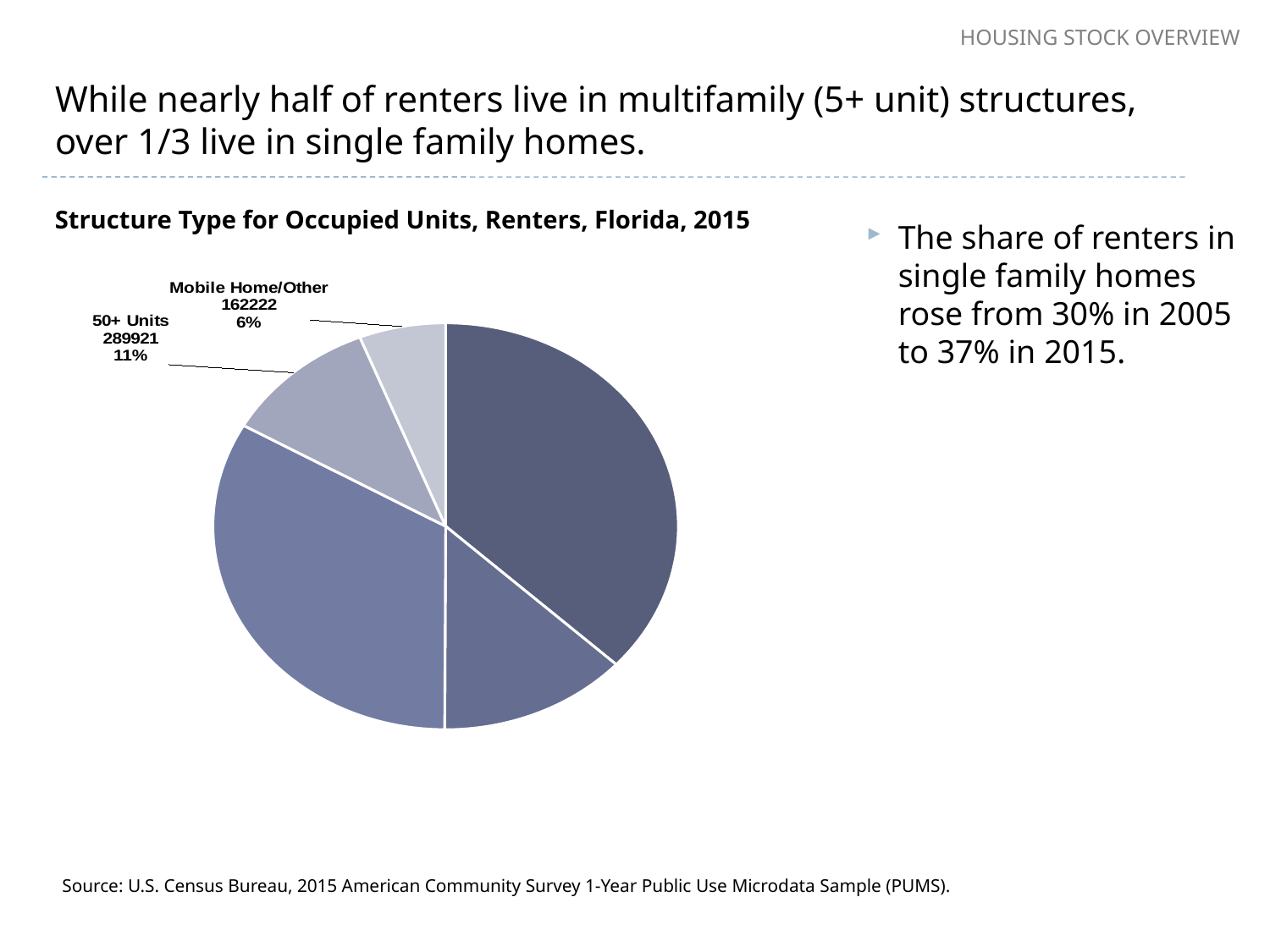
What share of the pie does 50+ Units represent? 11% What is the title of the chart? Structure Type for Occupied Units, Renters, Florida, 2015 What is the value shown for Mobile Home/Other? 162222 What kind of chart is shown on the slide? Pie chart How many slices does the pie chart have? 5 Which labeled category has the smallest slice of the pie? Mobile Home/Other What share of the pie does Mobile Home/Other represent? 6% By how many percentage points does the share for 50+ Units exceed the share for Mobile Home/Other? 5% What is the difference between the values for 50+ Units and Mobile Home/Other? 127699 Which is larger, the slice for 50+ Units or the slice for Mobile Home/Other? 50+ Units What is the value shown for 50+ Units? 289921